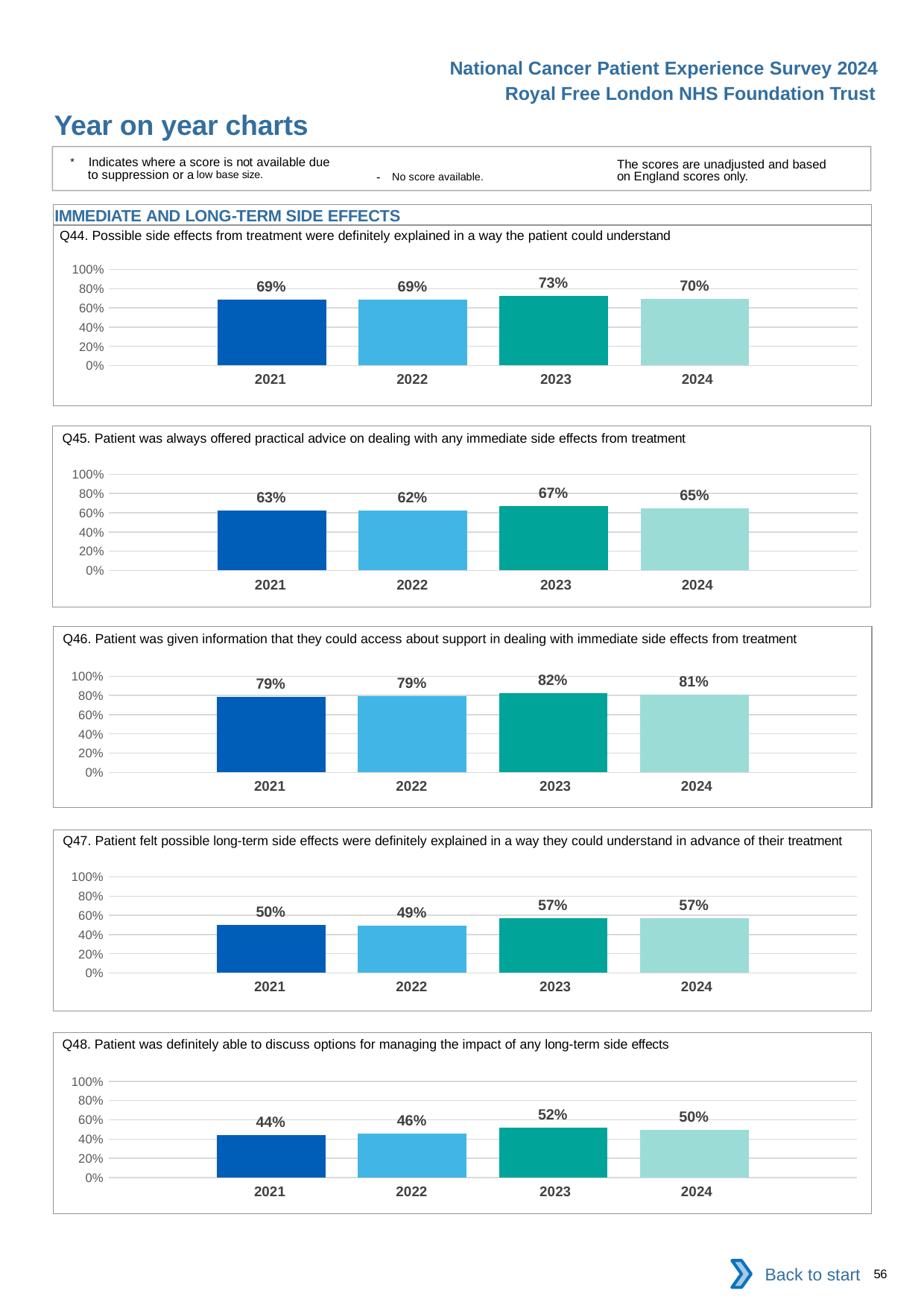
In the Q48 chart, what is the value for 2021? 44% How many bars are plotted in the Q44 chart? 4 In the Q47 chart, which year has the highest value? 2023 and 2024 (both 57%) In the Q47 chart, is the value for 2022 greater or less than 60%? less What type of chart is the Q45 chart? bar chart In the Q44 chart, what is the value for 2023? 73% In the Q48 chart, is the value for 2023 larger or smaller than the value for 2024? larger In the Q46 chart, what is the difference between the 2023 and 2021 values? 3% In the Q46 chart, what is the value for 2024? 81% In the Q45 chart, what is the difference between the 2024 and 2022 values? 3% In the Q45 chart, which year has the lowest value? 2022 How many charts are shown on the slide? 5